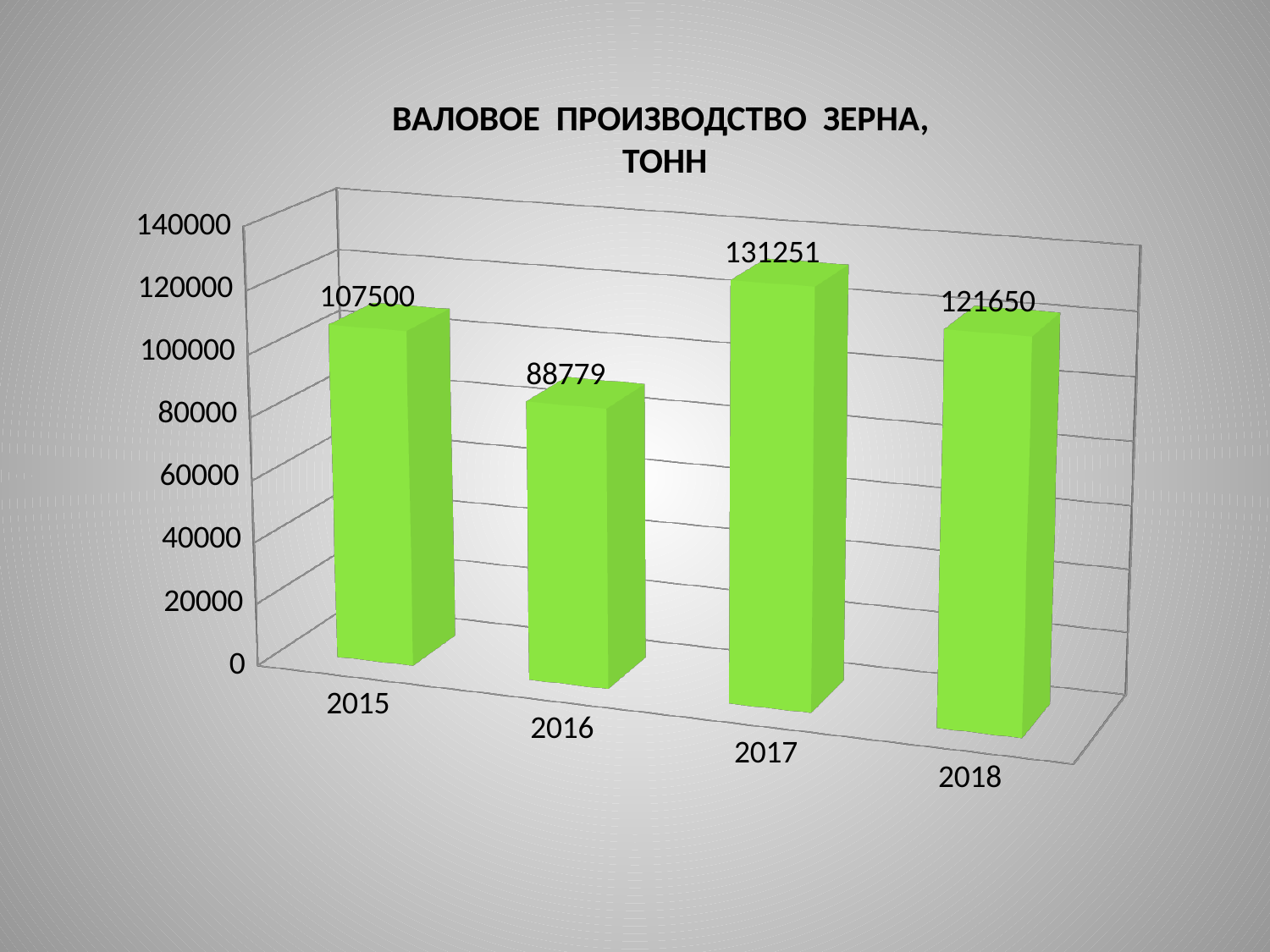
What is the value for 2018? 121650 What is the title of the chart? ВАЛОВОЕ ПРОИЗВОДСТВО ЗЕРНА, ТОНН Which year has the highest value? 2017 Which year has the lowest value? 2016 What is the difference between the values for 2017 and 2016? 42472 What is the difference between the values for 2018 and 2015? 14150 What kind of chart is this? bar chart What is the value for 2016? 88779 What is the value for 2015? 107500 What is the value for 2017? 131251 Which is larger, the value for 2015 or the value for 2018? 2018 How many years are shown on the chart? 4